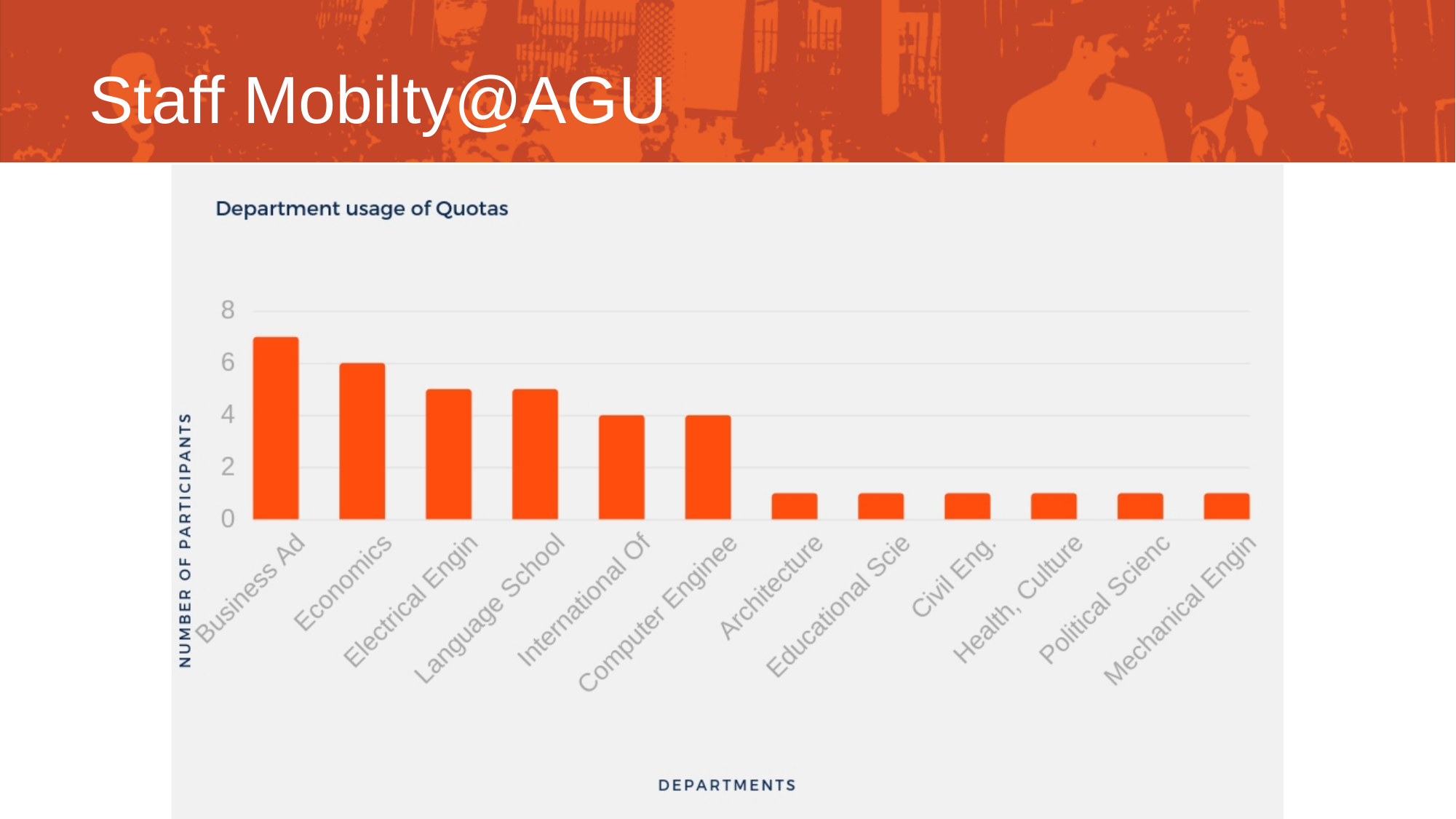
Do the values rise or fall moving from left to right along the x axis? Fall What is the title of the chart? Department usage of Quotas What is the number of participants for International Of? 4 Which department has the highest number of participants? Business Ad How many departments are shown on the x axis of the chart? 12 What is the difference in participants between Economics and International Of? 2 What is the number of participants for Computer Enginee? 4 What is the number of participants for Economics? 6 Which has more participants, Business Ad or Economics? Business Ad What kind of chart is shown on the slide? Bar chart Is the value for Architecture greater or less than 2? less Is the value for Business Ad greater or less than 6? greater